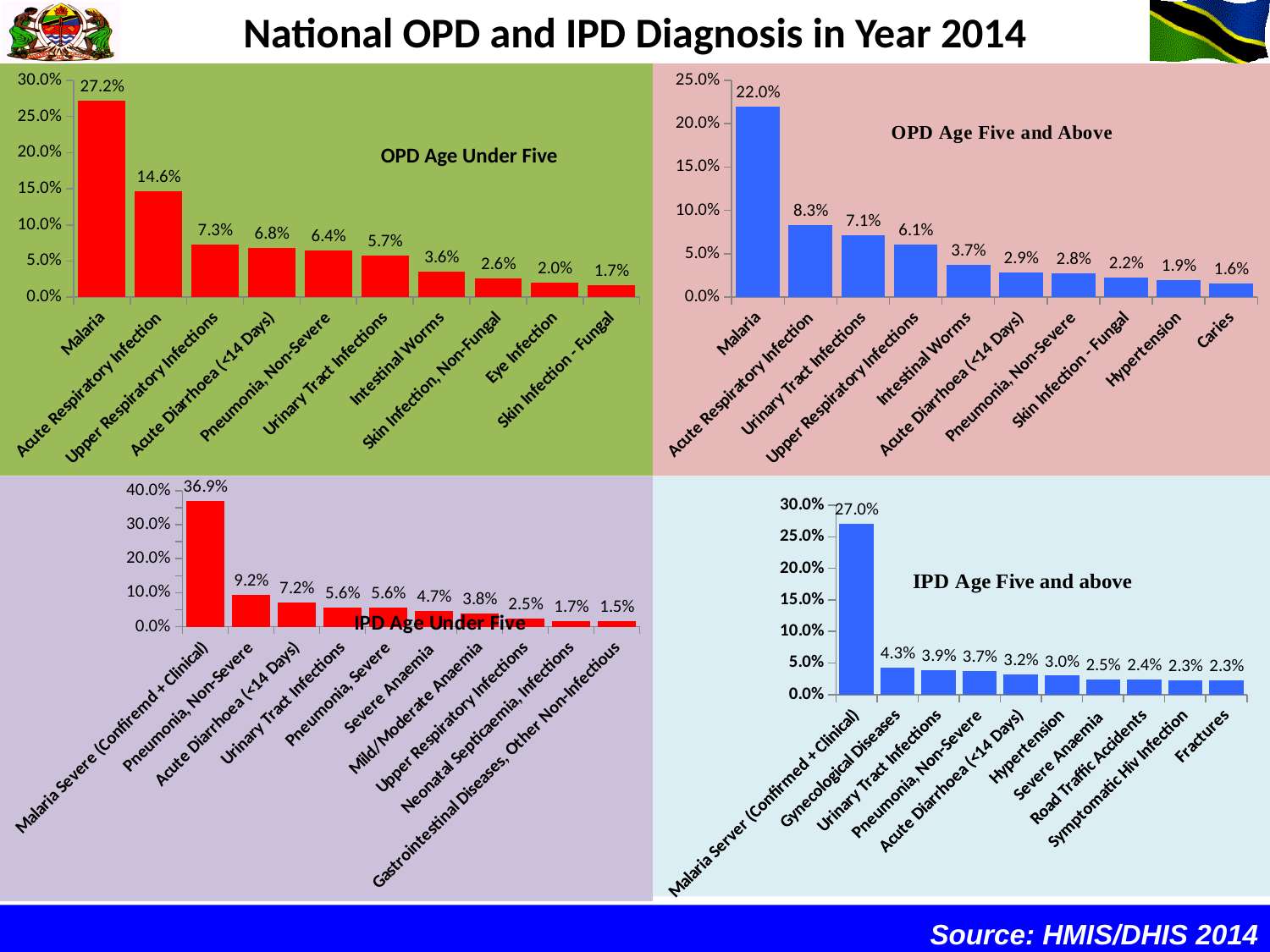
In the OPD Age Under Five chart, what is the value for Malaria? 27.2% In the IPD Age Under Five chart, which category has the highest value? Malaria Severe (Confiremd + Clinical) In the OPD Age Under Five chart, do the values rise or fall from left to right along the x axis? fall In the IPD Age Under Five chart, how many categories are plotted? 10 In the IPD Age Under Five chart, what is the value for Severe Anaemia? 4.7% In the OPD Age Under Five chart, what is the value for Acute Diarrhoea (<14 Days)? 6.8% In the OPD Age Five and Above chart, which category has the lowest value? Caries In the IPD Age Five and above chart, what is the value for Road Traffic Accidents? 2.4% In the OPD Age Five and Above chart, what is the difference between Malaria and Acute Respiratory Infection? 13.7% What kind of chart is the OPD Age Five and Above chart? bar chart In the IPD Age Five and above chart, which is larger, Gynecological Diseases or Hypertension? Gynecological Diseases In the OPD Age Five and Above chart, what is the value for Hypertension? 1.9%